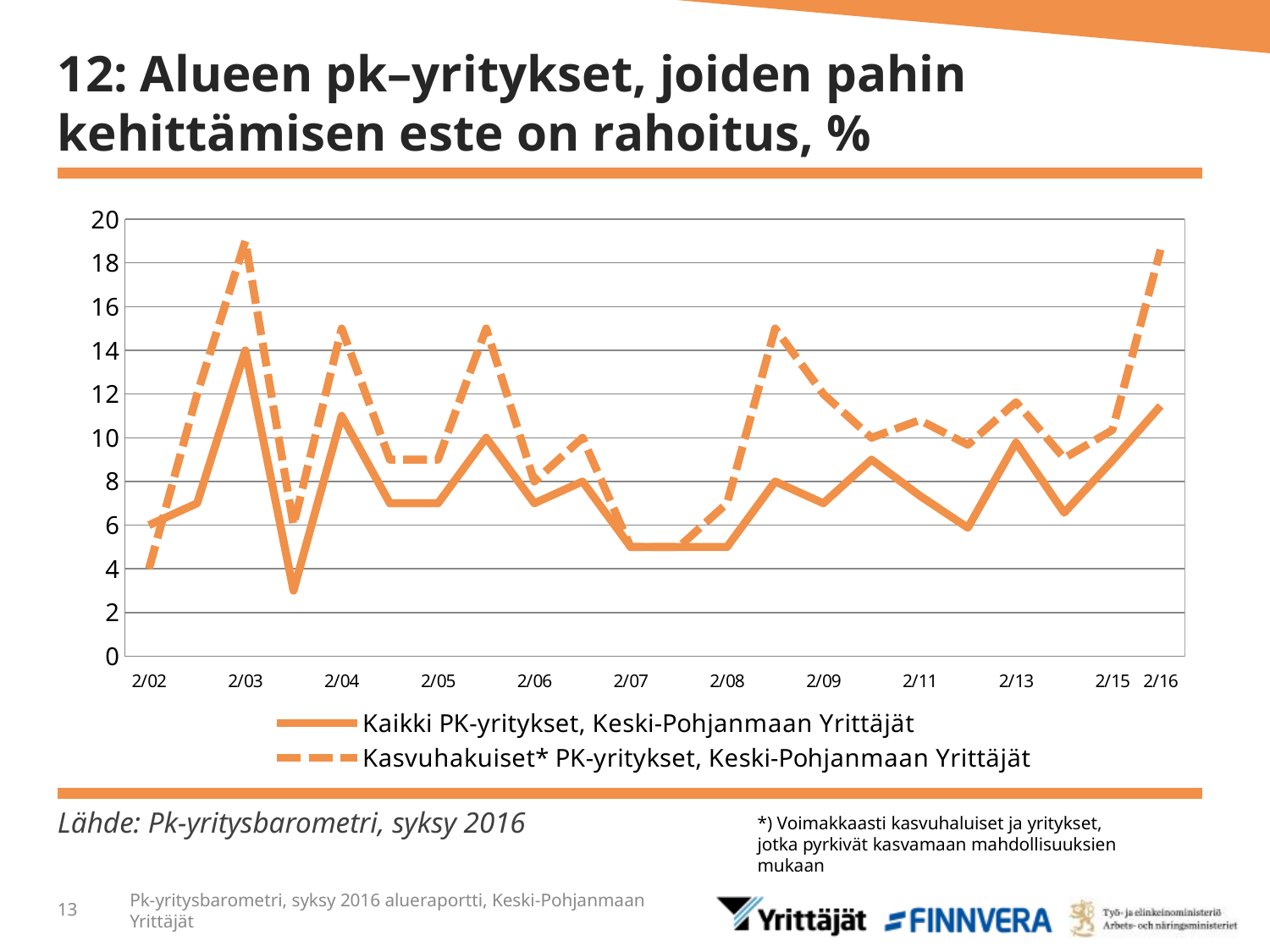
At 2/16, which series has the larger value, Kaikki PK-yritykset or Kasvuhakuiset* PK-yritykset? Kasvuhakuiset* PK-yritykset Is the value for Kasvuhakuiset* PK-yritykset at 2/16 greater or less than 16? greater What kind of chart is shown on the slide? line chart How many labels are shown on the x axis? 12 Is the value for Kaikki PK-yritykset at 2/07 greater or less than 6? less Is the value for Kasvuhakuiset* PK-yritykset at 2/03 greater or less than 16? greater Which series reaches the highest value anywhere on the chart? Kasvuhakuiset* PK-yritykset, Keski-Pohjanmaan Yrittäjät Which series is drawn with a dashed line? Kasvuhakuiset* PK-yritykset, Keski-Pohjanmaan Yrittäjät Between 2/15 and 2/16, does the Kaikki PK-yritykset line rise or fall? rise How many series does the legend list? 2